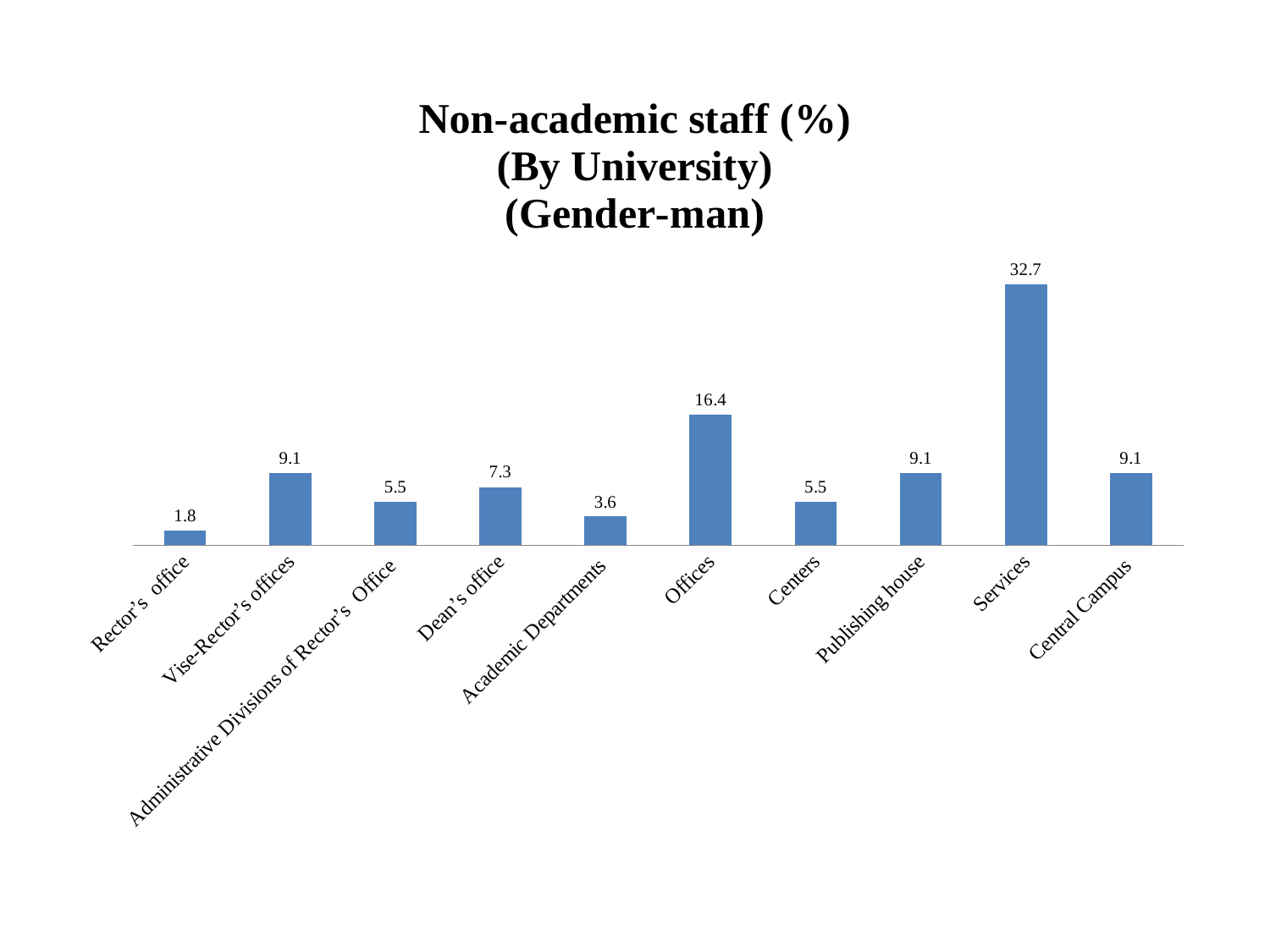
What is the difference between the values for Dean's office and Centers? 1.8 Which is larger, the value for Vise-Rector's offices or the value for Dean's office? Vise-Rector's offices What is the value for Services? 32.7 What is the value for Rector's office? 1.8 How many categories are shown on the chart? 10 What is the title of the chart? Non-academic staff (%) (By University) (Gender-man) Which category has the highest value? Services What is the value for Offices? 16.4 What is the value for Academic Departments? 3.6 What is the difference between the values for Services and Offices? 16.3 What kind of chart is shown on the slide? Bar chart Which category has the lowest value? Rector's office